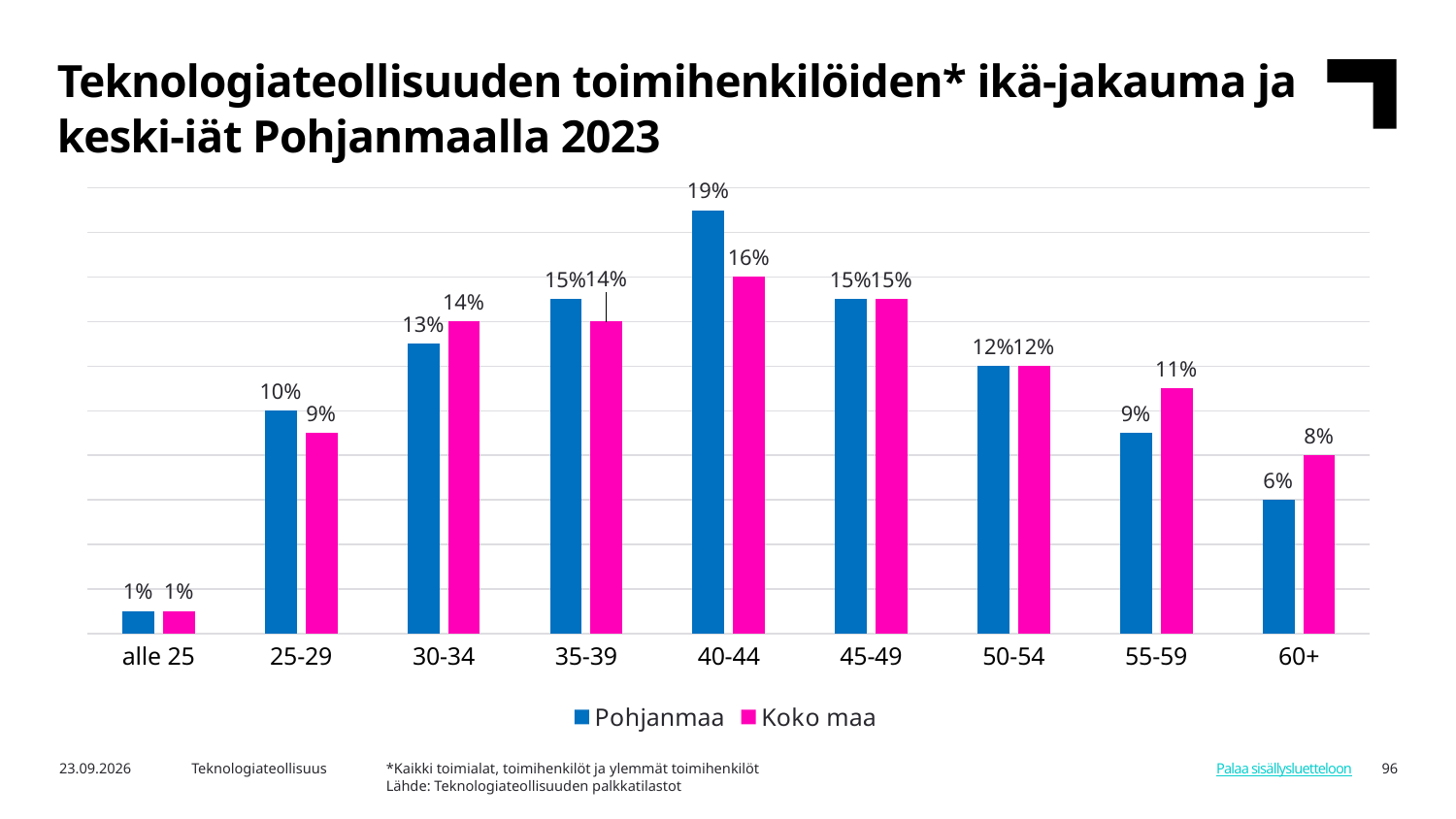
Which colour represents the Koko maa series? Pink What kind of chart is shown on the slide? Bar chart For the 55-59 age group, which series has the larger value, Pohjanmaa or Koko maa? Koko maa What is the Pohjanmaa value for the 25-29 age group? 10% What is the Pohjanmaa value for the 40-44 age group? 19% What is the difference between the Pohjanmaa and Koko maa values for the 40-44 age group? 3% What is the Koko maa value for the 60+ age group? 8% What is the difference between the Koko maa values for the 30-34 and 60+ age groups? 6% Which age group has the highest Pohjanmaa value? 40-44 How many series does the legend list? 2 How many age groups are shown on the x axis? 9 Which age group has the lowest Koko maa value? alle 25